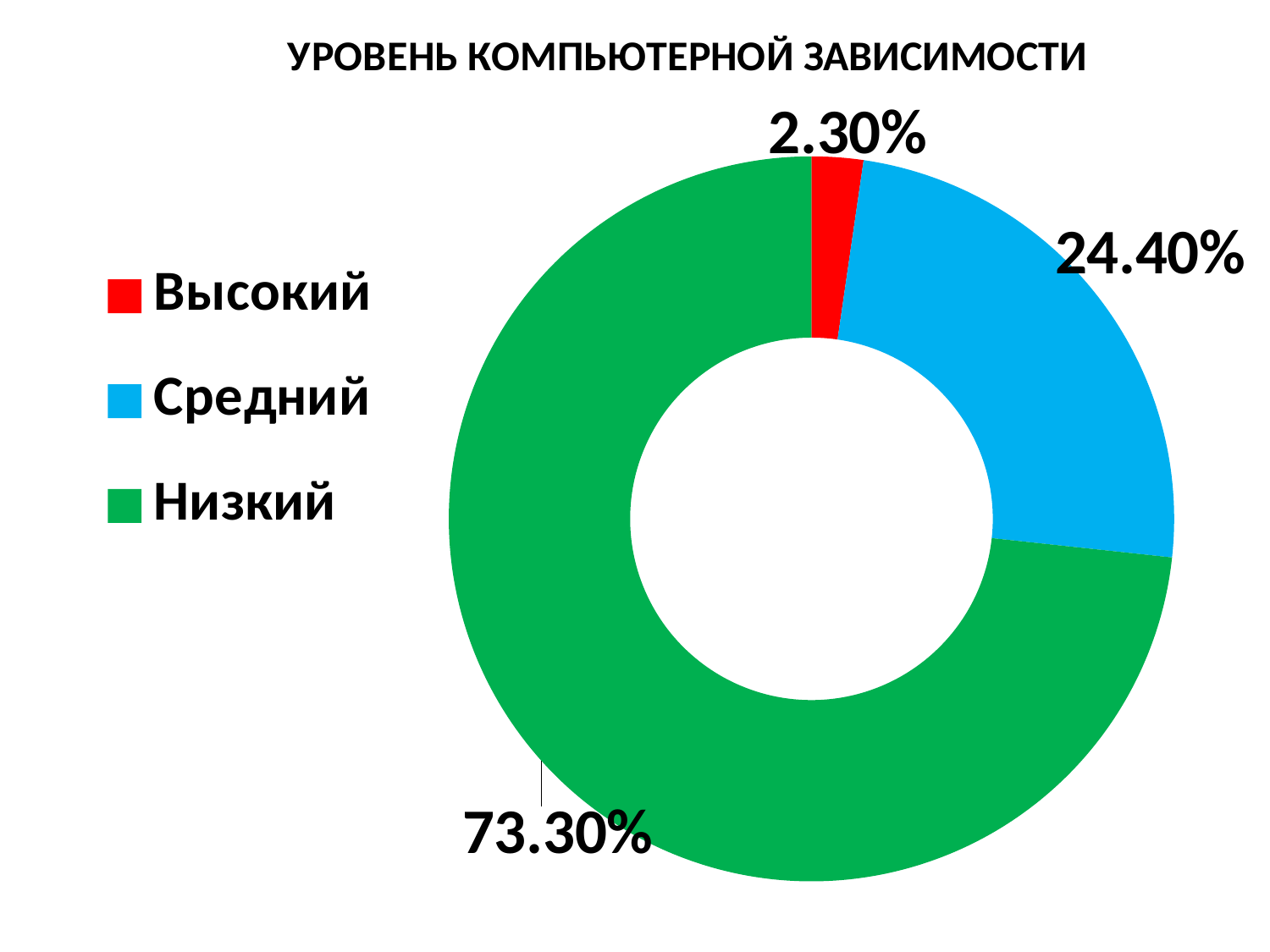
What is the difference between the values for Средний and Высокий? 22.10% Which category has the largest share? Низкий What is the value for Высокий? 2.30% Which is larger, the value for Средний or the value for Высокий? Средний What is the title of the chart? УРОВЕНЬ КОМПЬЮТЕРНОЙ ЗАВИСИМОСТИ How many categories does the chart show? 3 What kind of chart is shown on the slide? Doughnut chart What is the value for Низкий? 73.30% What colour represents Средний in the chart? Blue What is the value for Средний? 24.40% What is the difference between the values for Низкий and Средний? 48.90% Which category has the smallest share? Высокий